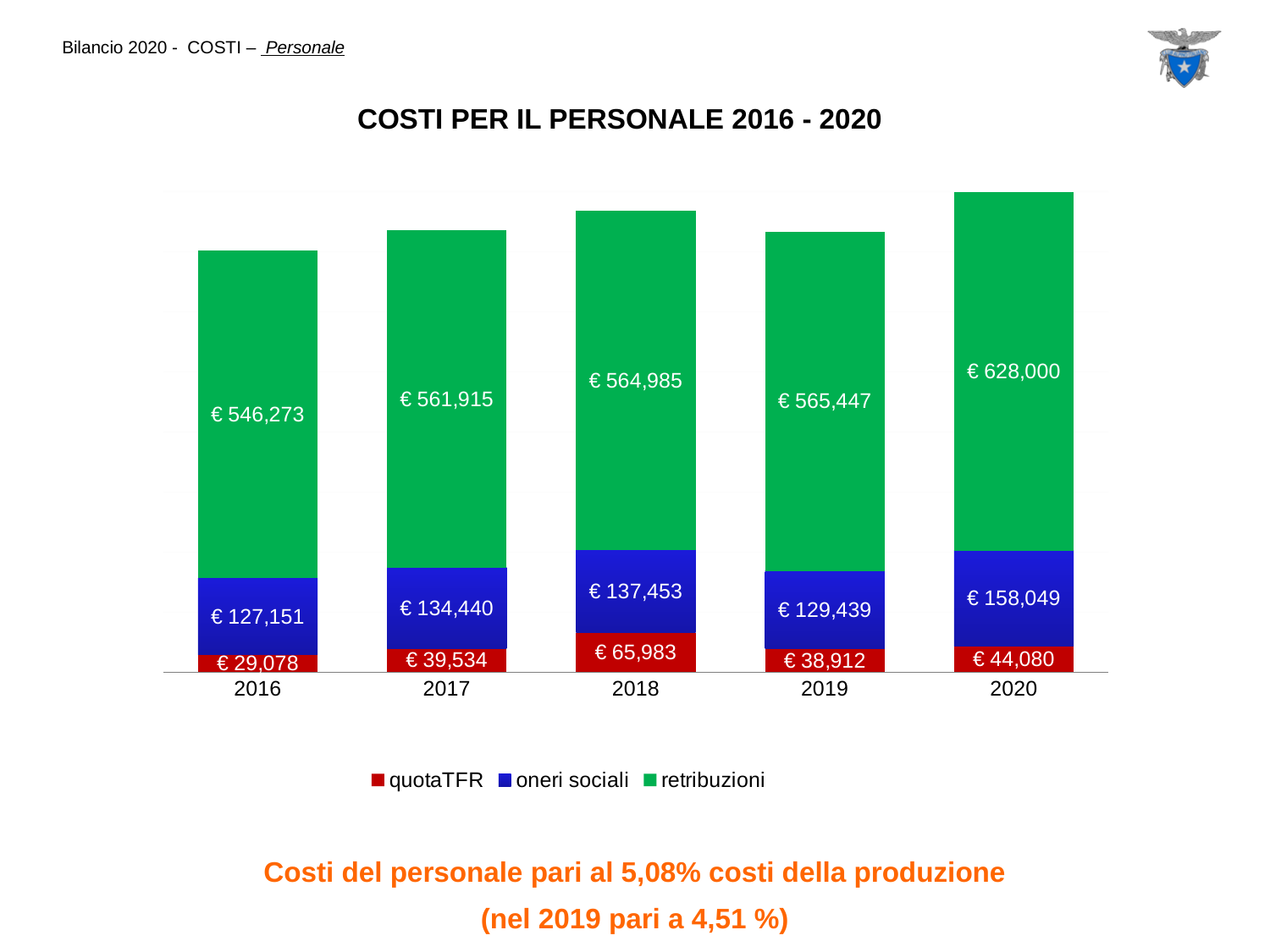
What is the value of quotaTFR for 2018? € 65,983 What is the difference between the retribuzioni values for 2020 and 2019? € 62,553 Which is larger, the oneri sociali value for 2018 or for 2019? 2018 What is the value of oneri sociali for 2017? € 134,440 Which year has the lowest retribuzioni value? 2016 How many series does the legend list? 3 Which year has the highest quotaTFR value? 2018 What is the total of the stacked bar for 2020? € 830,129 Which colour represents the retribuzioni series? Green What is the value of retribuzioni for 2020? € 628,000 What kind of chart is shown on the slide? Stacked bar chart How many years are shown on the x axis? 5